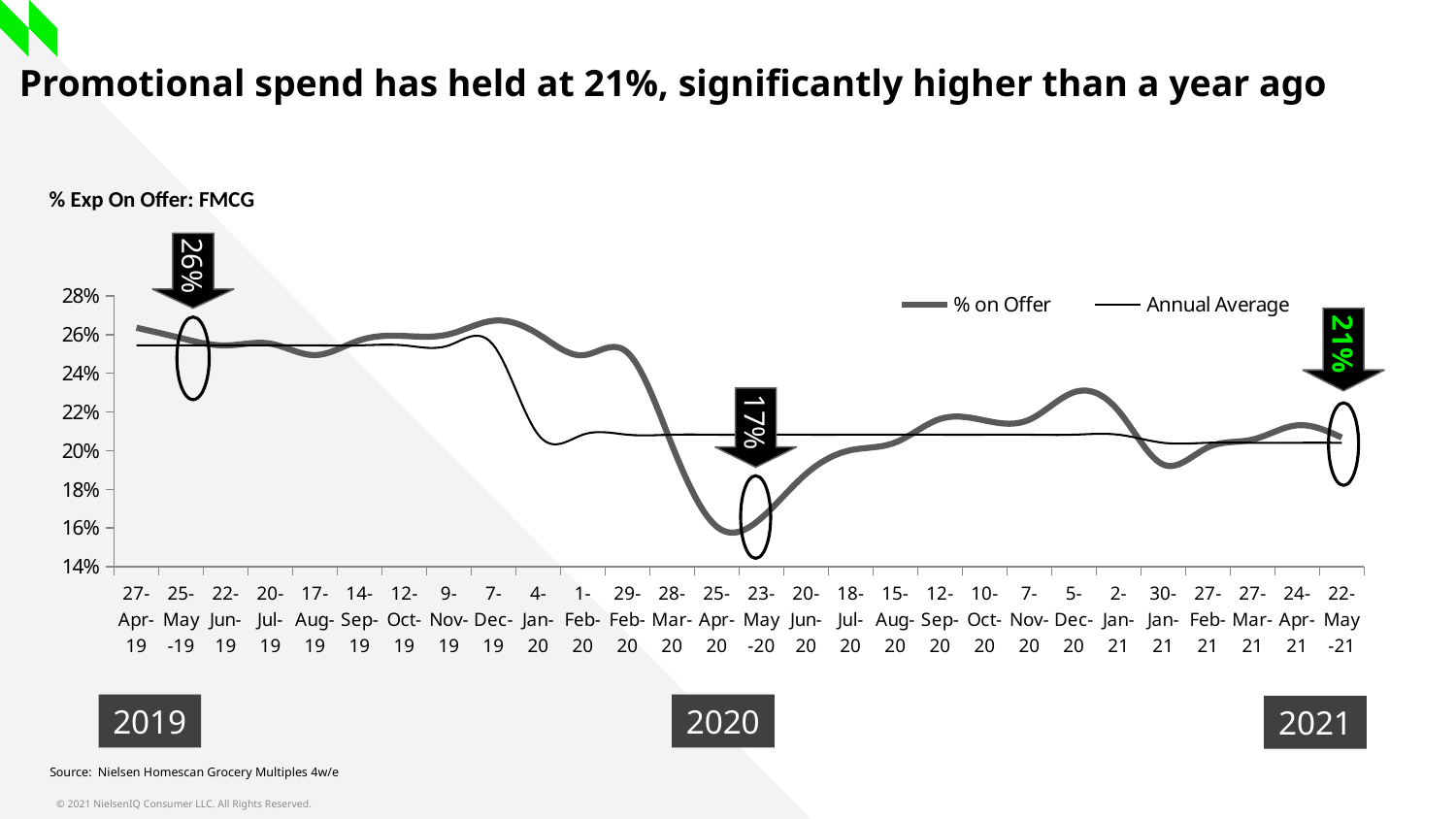
What value does the callout arrow show for the % on Offer at 25-May-19? 26% Which callout value is larger, the one for May 2019 or the one for May 2021? May 2019 How many series does the chart legend list? 2 Is the % on Offer value at 7-Dec-19 greater or less than 24%? greater By how many percentage points does the May 2019 callout value (26%) exceed the May 2020 callout value (17%)? 9 percentage points What value does the callout arrow show for the % on Offer at 22-May-21? 21% At which date does the % on Offer line reach its lowest point? 25-Apr-20 What is the title of the chart? % Exp On Offer: FMCG What are the two series named in the chart legend? % on Offer and Annual Average What value does the callout arrow show for the % on Offer at 23-May-20? 17% What kind of chart is shown on the slide? Line chart Is the % on Offer value at 25-Apr-20 greater or less than 18%? less